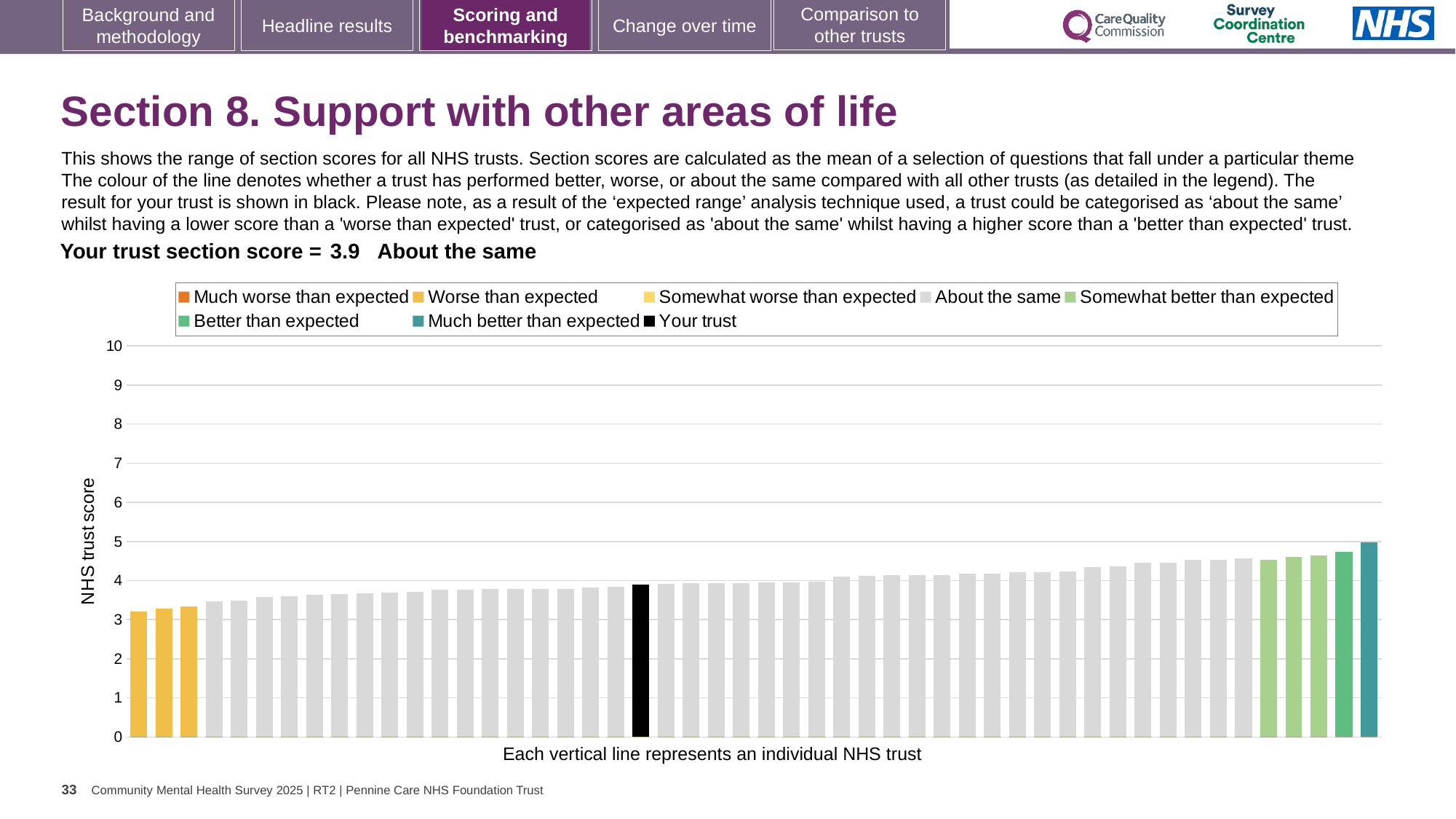
What kind of chart is shown on the slide? bar chart Is the value of the lowest bar on the chart greater or less than 3? greater Which legend category does the lowest bar on the chart belong to? Worse than expected What is the label on the vertical axis of the chart? NHS trust score How many entries does the chart legend list? 8 What colour is used for the 'Your trust' bar in the chart? black How many bars are coloured as 'Worse than expected'? 3 Do the bar values rise or fall from left to right along the x axis? rise Is the value of the black 'Your trust' bar greater or less than 4? less How many bars are coloured as 'Somewhat better than expected'? 3 Which legend category does the highest bar on the chart belong to? Much better than expected What is the section score for your trust shown on the slide? 3.9